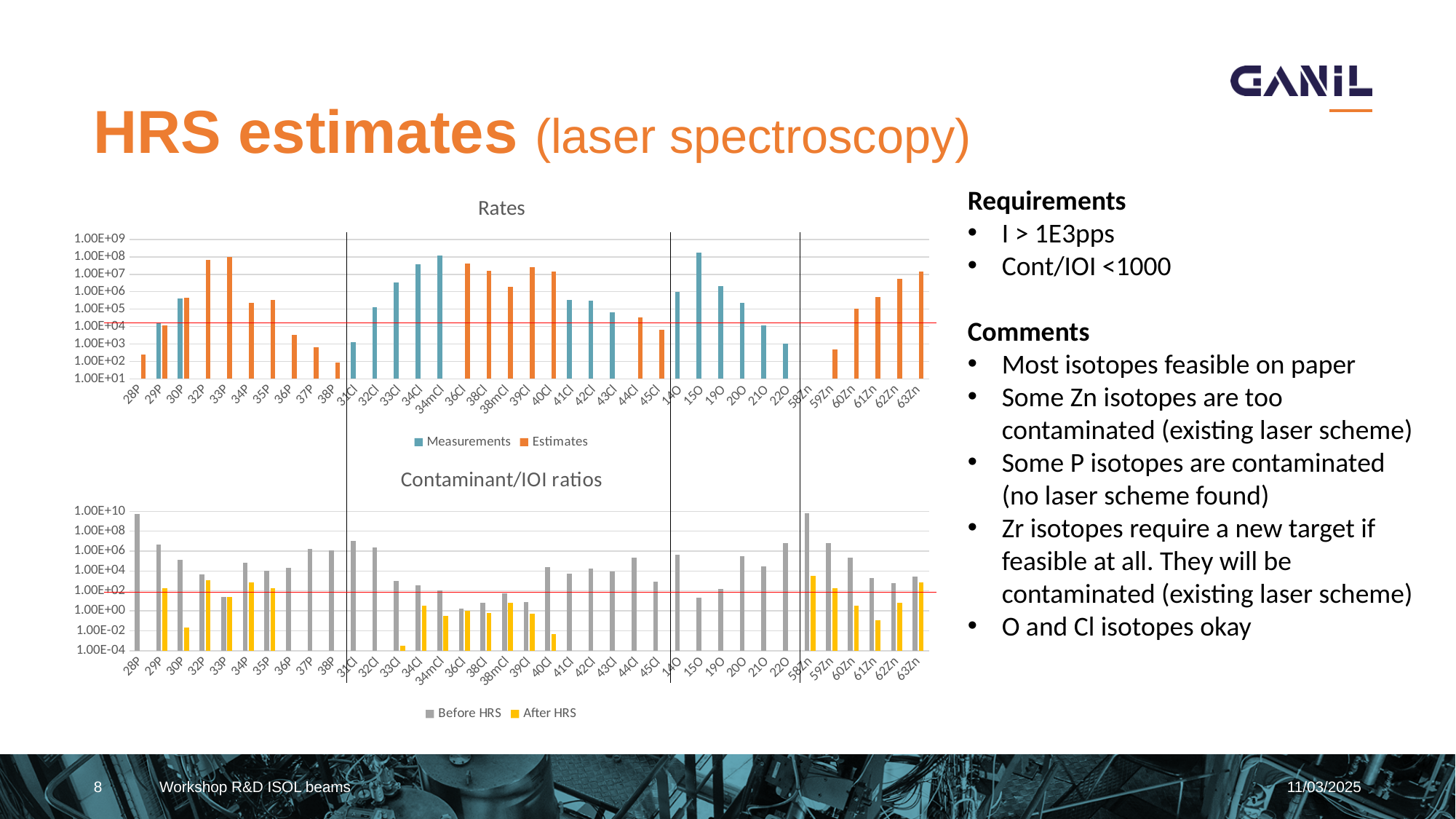
What kind of chart is the 'Rates' chart? bar chart In the 'Contaminant/IOI ratios' chart, is the Before HRS value for 28P greater or less than 1.00E+08? greater In the 'Rates' chart, is the value for 59Zn greater or less than 1.00E+03? less In the 'Contaminant/IOI ratios' chart, is the After HRS value for 33Cl greater or less than 1.00E-02? less In the 'Rates' chart, which has the larger value, 33P or 28P? 33P What are the two legend entries of the 'Contaminant/IOI ratios' chart? Before HRS, After HRS In the 'Contaminant/IOI ratios' chart, which is larger for 29P, the Before HRS value or the After HRS value? Before HRS How many isotope categories are shown on the x axis of the 'Rates' chart? 37 In the 'Rates' chart, which has the larger value, 15O or 22O? 15O How many series does the legend of the 'Rates' chart list? 2